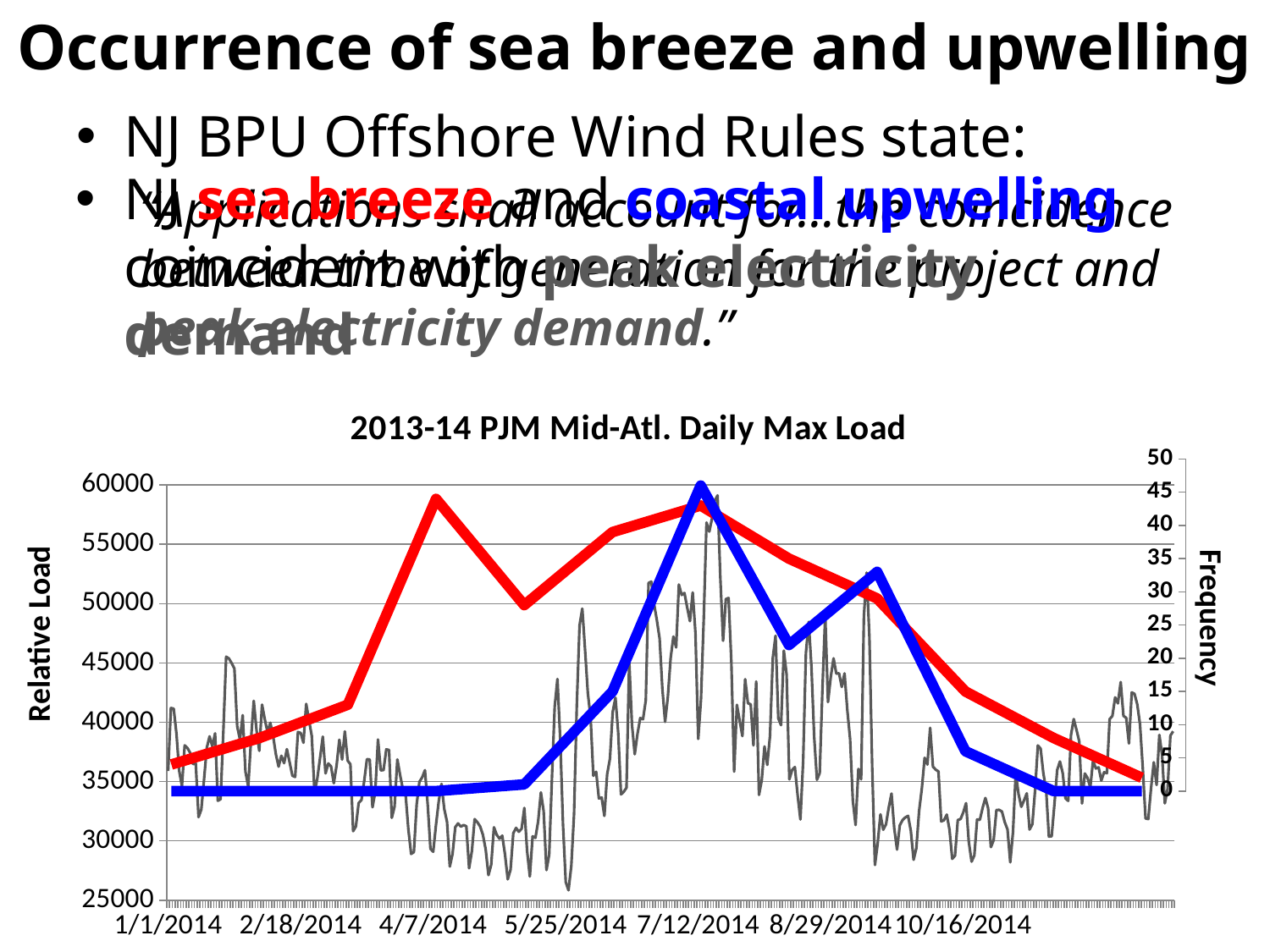
How many date labels are shown along the x axis of the chart? 7 Is the value of the blue line at 1/1/2014, read on the right-hand Frequency axis, greater or less than 5? less What is the highest tick value shown on the right-hand Frequency axis? 50 What is the label of the left vertical axis of the chart? Relative Load Is the value of the red line at 4/7/2014, read on the right-hand Frequency axis, greater or less than 35? greater Is the peak value of the blue line, read on the right-hand Frequency axis, greater or less than 40? greater How many lines are plotted on the chart? 3 What kind of chart is shown on the slide? Line chart Does the red line rise or fall between 1/1/2014 and 4/7/2014? rise Does the red line rise or fall between 7/12/2014 and the end of the x axis? fall What is the title of the chart on the slide? 2013-14 PJM Mid-Atl. Daily Max Load